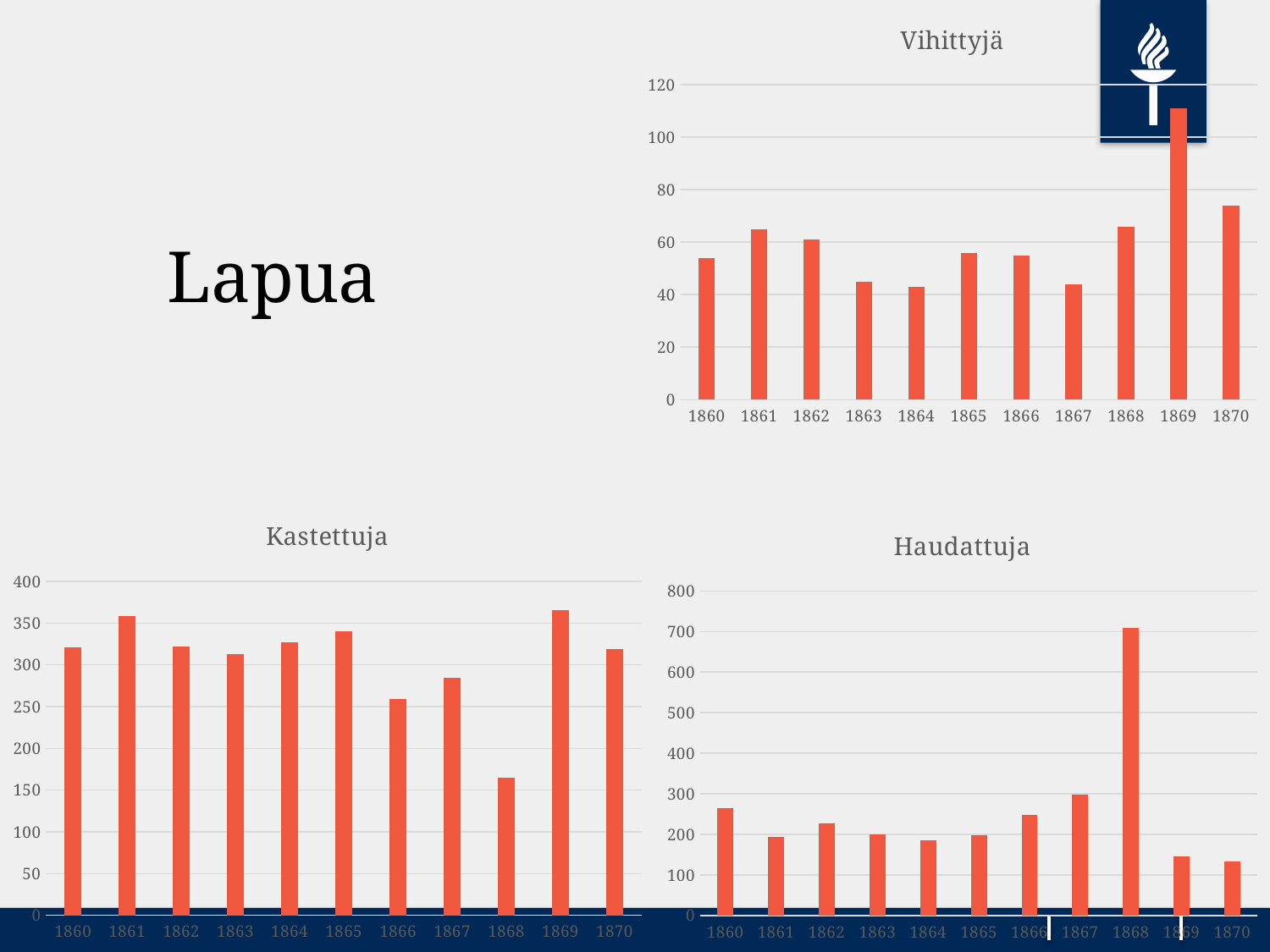
In the Kastettuja chart, is the value for 1867 greater or less than 300? less In the Vihittyjä chart, is the value for 1860 greater or less than 40? greater How many years are shown on the x axis of the Vihittyjä chart? 11 What is the title of the chart at the bottom left of the slide? Kastettuja In the Haudattuja chart, which is larger, the value for 1866 or the value for 1867? 1867 In the Vihittyjä chart, which year has the highest value? 1869 In the Vihittyjä chart, is the value for 1869 greater or less than 100? greater In the Haudattuja chart, which year has the highest value? 1868 In the Kastettuja chart, which year has the lowest value? 1868 What kind of chart is the Vihittyjä chart? bar chart